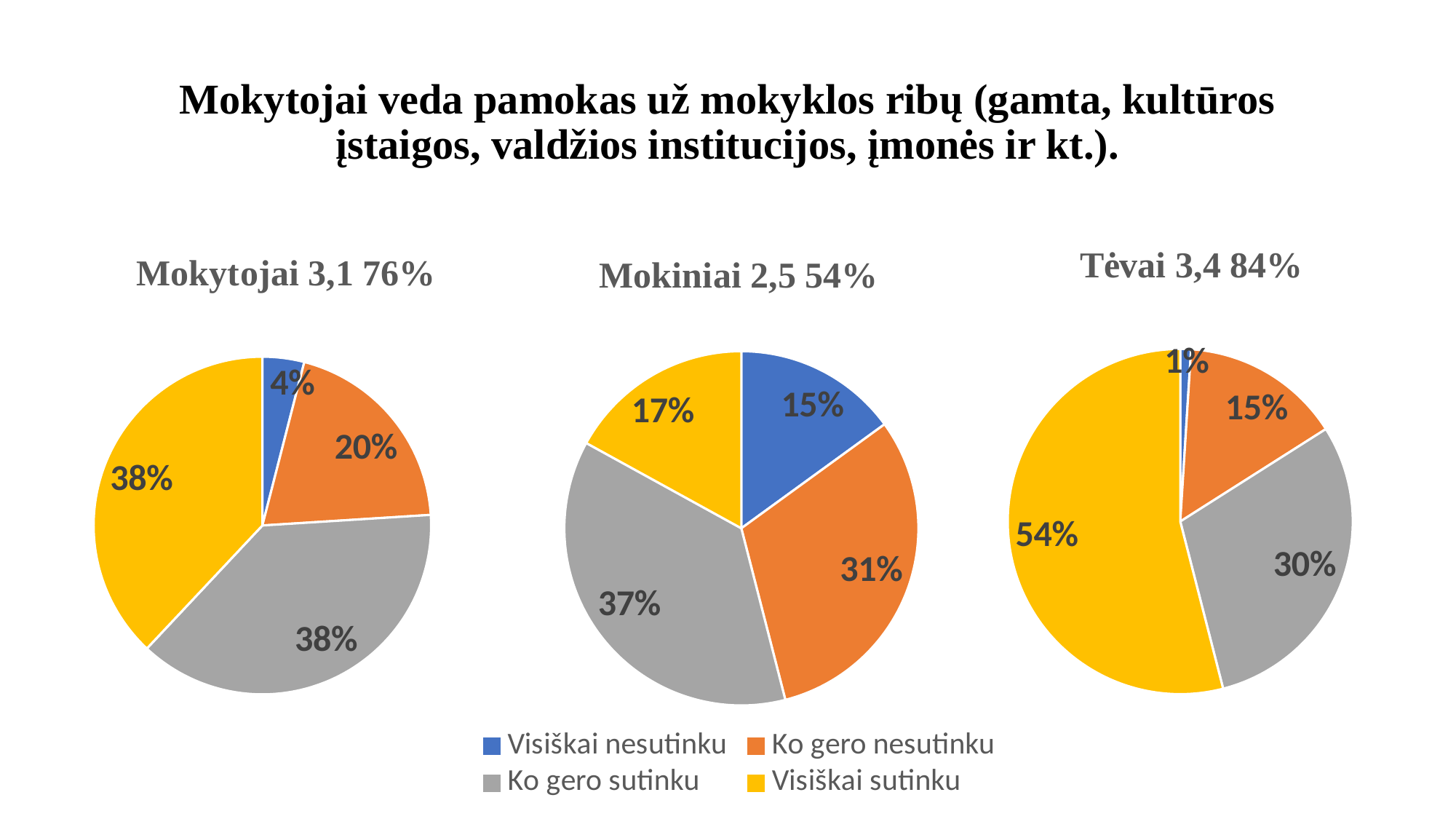
In the 'Tėvai 3,4 84%' pie chart, which is larger: 'Ko gero sutinku' or 'Ko gero nesutinku'? Ko gero sutinku In the 'Tėvai 3,4 84%' pie chart, which category has the smallest slice? Visiškai nesutinku In the 'Mokiniai 2,5 54%' pie chart, what is the difference between the 'Ko gero nesutinku' and 'Visiškai sutinku' shares? 14% How many slices does the 'Mokiniai 2,5 54%' pie chart have? 4 Is the 'Visiškai sutinku' share larger in the 'Mokytojai 3,1 76%' chart or in the 'Mokiniai 2,5 54%' chart? Mokytojai 3,1 76% In the 'Mokiniai 2,5 54%' pie chart, what share is labelled for 'Visiškai nesutinku'? 15% In the 'Tėvai 3,4 84%' pie chart, what share is labelled for 'Visiškai sutinku'? 54% In the 'Mokytojai 3,1 76%' pie chart, what share is labelled for 'Ko gero nesutinku'? 20% In the 'Mokiniai 2,5 54%' pie chart, which category has the largest slice? Ko gero sutinku How many entries does the shared legend list? 4 In the 'Mokytojai 3,1 76%' pie chart, which category has the smallest slice? Visiškai nesutinku What type of chart is used for 'Tėvai 3,4 84%'? Pie chart